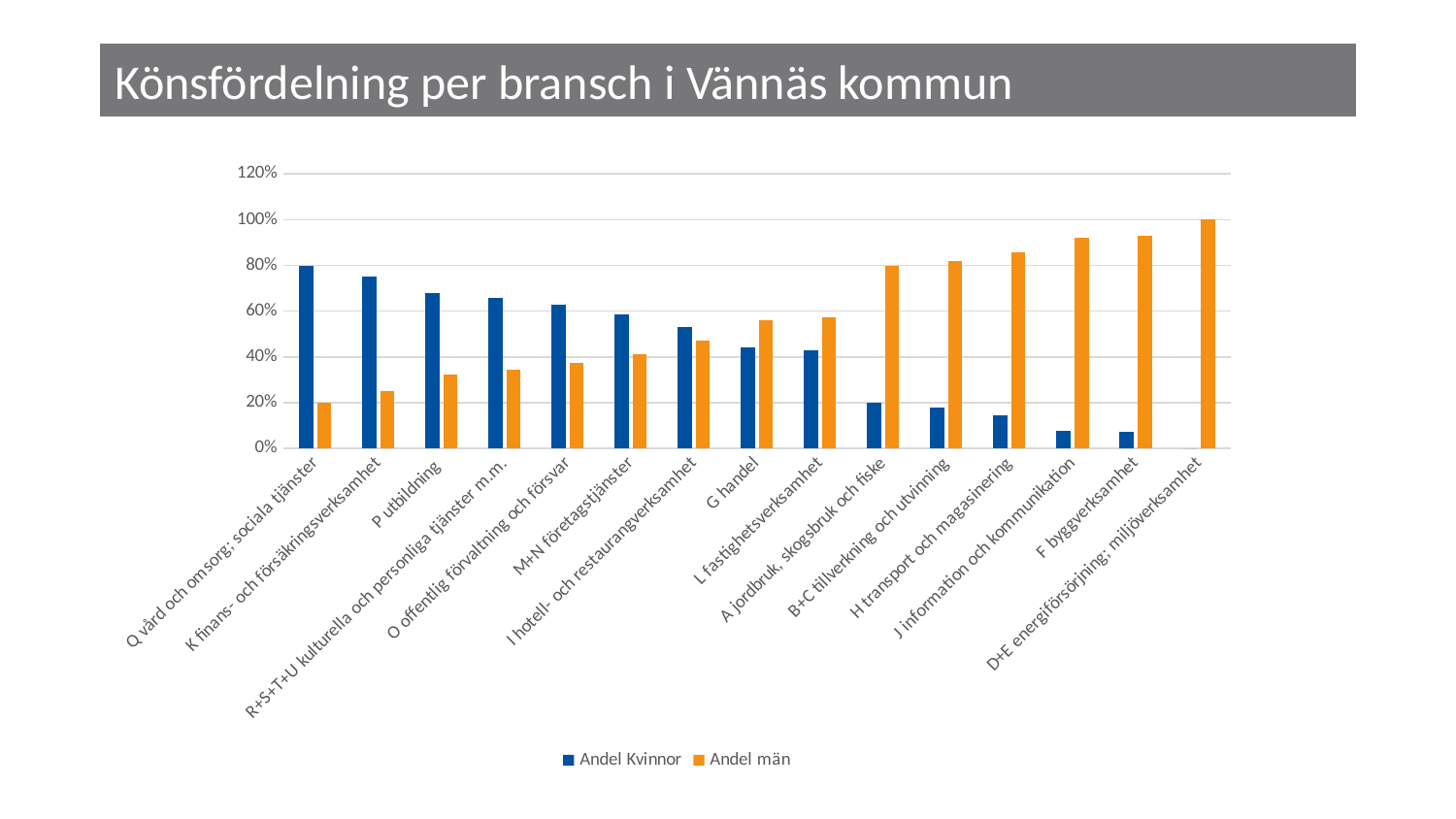
How many industry categories are shown on the x axis? 15 Do the values for Andel män generally rise or fall from left to right along the x axis? rise What is the title of the chart? Könsfördelning per bransch i Vännäs kommun Is the value of Andel Kvinnor for P utbildning greater or less than 60%? greater Which category has the highest value for Andel Kvinnor? Q vård och omsorg; sociala tjänster Which category has the highest value for Andel män? D+E energiförsörjning; miljöverksamhet Which category has the lowest value for Andel män? Q vård och omsorg; sociala tjänster What is the value of Andel män for D+E energiförsörjning; miljöverksamhet? 100% For G handel, which is larger, Andel Kvinnor or Andel män? Andel män Is the value of Andel män for H transport och magasinering greater or less than 80%? greater How many series does the legend list? 2 What kind of chart is shown on the slide? bar chart